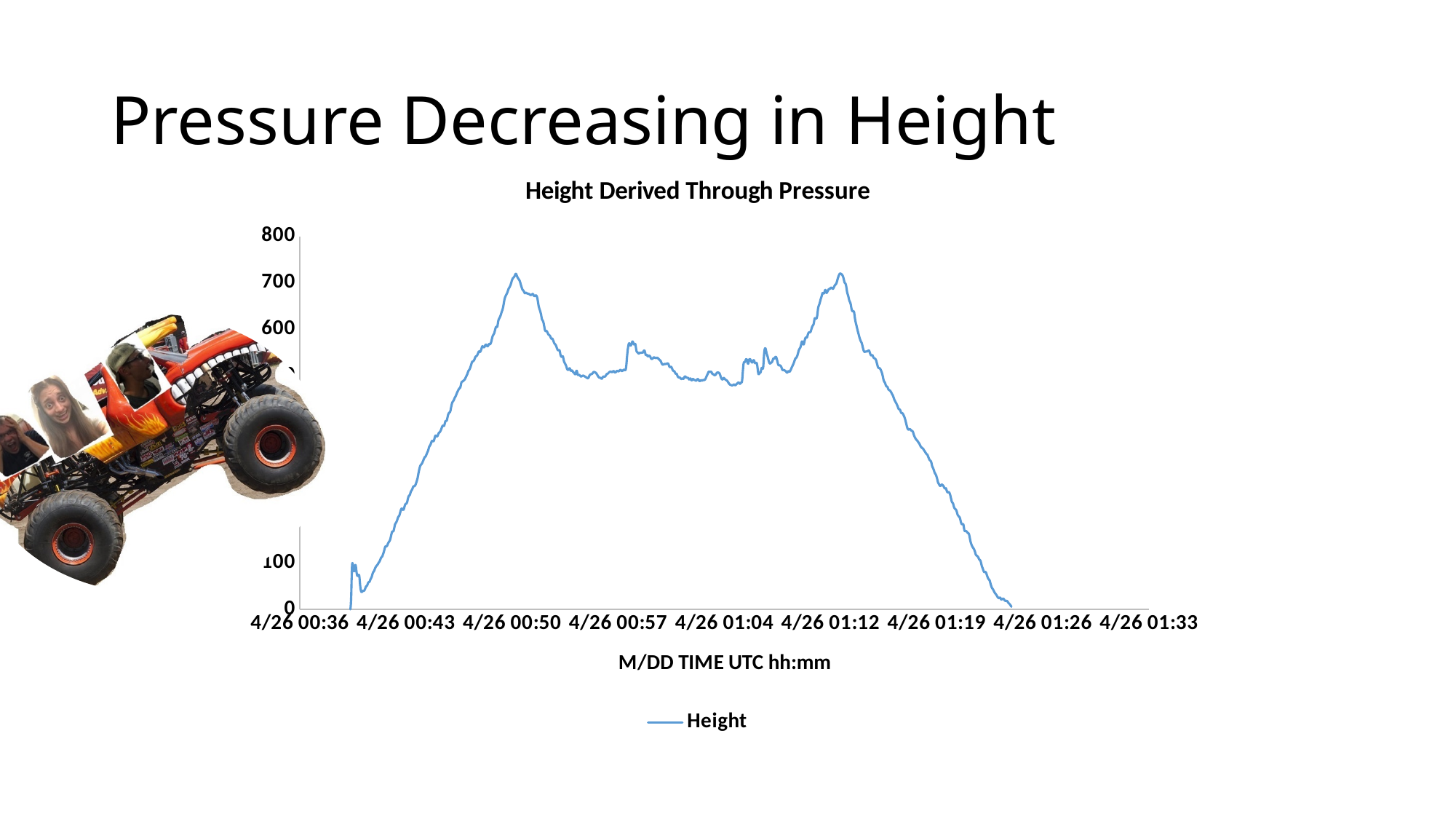
Does the Height line rise or fall between 4/26 01:12 and 4/26 01:26? fall Is the value for Height at 4/26 00:50 greater or less than 600? greater What kind of chart is shown on the slide? line chart Is the value for Height at 4/26 00:57 greater or less than 600? less Is the value for Height at 4/26 01:19 greater or less than 600? less What is the title of the chart? Height Derived Through Pressure Does the Height line rise or fall between 4/26 00:43 and 4/26 00:50? rise What is the x-axis label of the chart? M/DD TIME UTC hh:mm How many time labels are shown on the x axis? 9 How many series does the legend list? 1